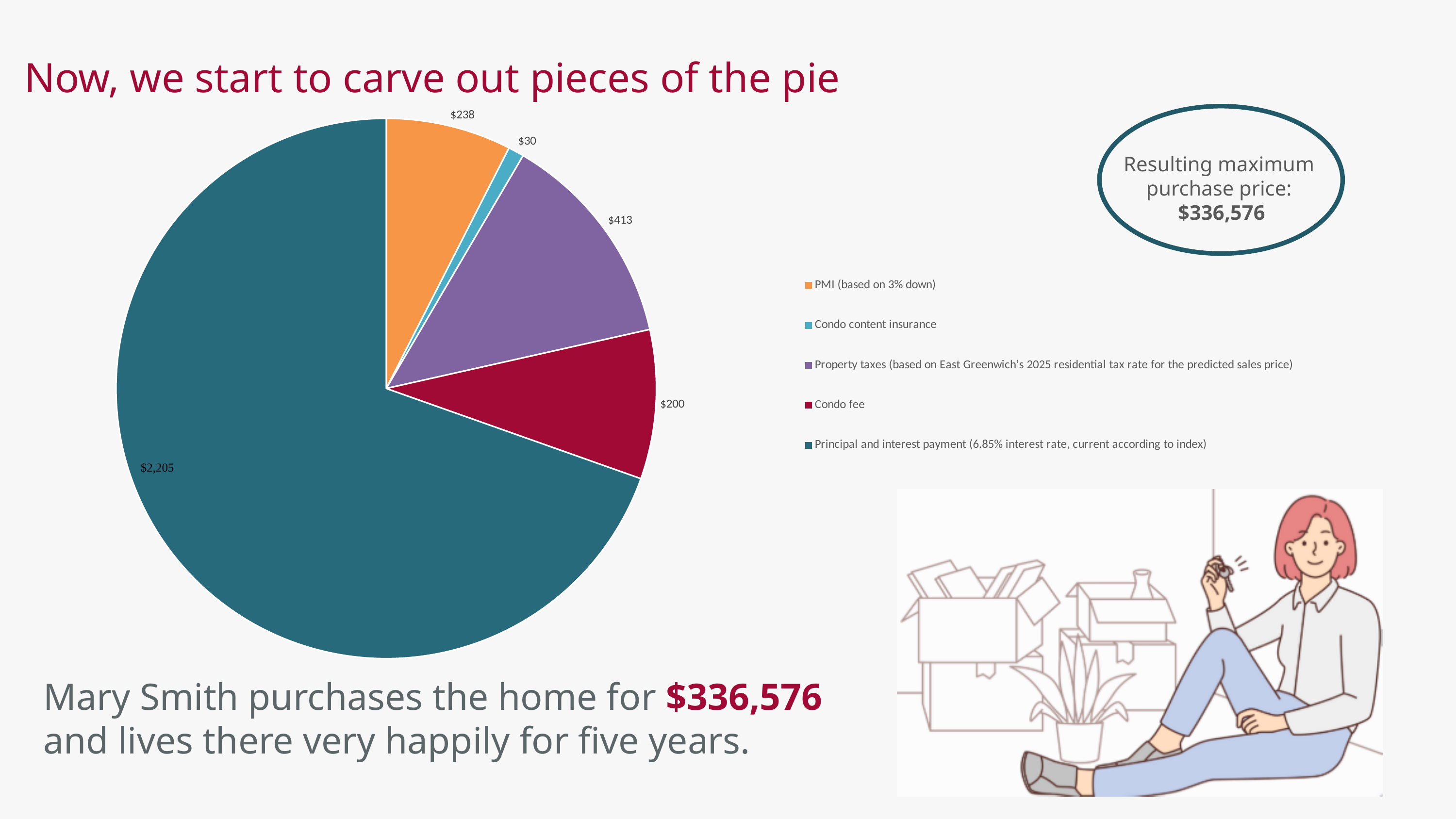
Which slice of the pie chart is the smallest? Condo content insurance What is the value of the Principal and interest payment slice? $2,205 What is the value of the Condo content insurance slice? $30 Which slice of the pie chart is the largest? Principal and interest payment What type of chart is shown on the slide? pie chart What is the difference between the Property taxes slice and the Condo fee slice? $213 What colour is the Condo fee slice in the pie chart? dark red How many slices does the pie chart have? 5 What is the value of the PMI (based on 3% down) slice? $238 What is the value of the Property taxes slice? $413 How many entries does the legend of the pie chart list? 5